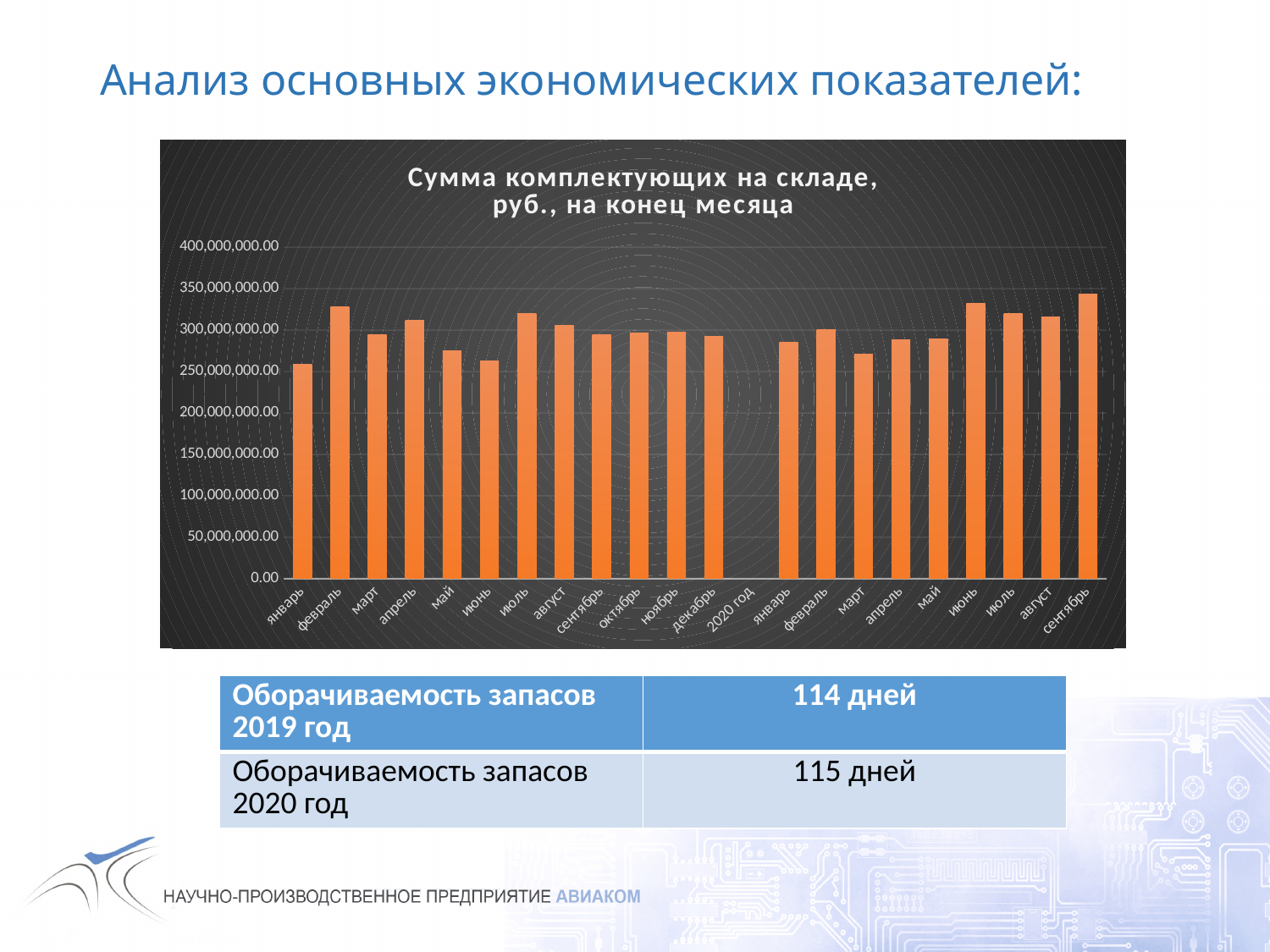
Which is larger, the value for январь (2019) or февраль (2019)? февраль (2019) What is the title of the chart? Сумма комплектующих на складе, руб., на конец месяца What kind of chart is shown on the slide? bar chart How many bars are plotted in the chart? 21 Is the value for февраль (2019) greater or less than 300,000,000.00? greater What is the highest value shown on the vertical axis of the chart? 400,000,000.00 Do the values rise or fall from март (2020) to июнь (2020)? rise Is the value for сентябрь (2020) greater or less than 300,000,000.00? greater Is the value for июнь (2019) greater or less than 300,000,000.00? less Which is larger, the value for июнь (2019) or июль (2019)? июль (2019)